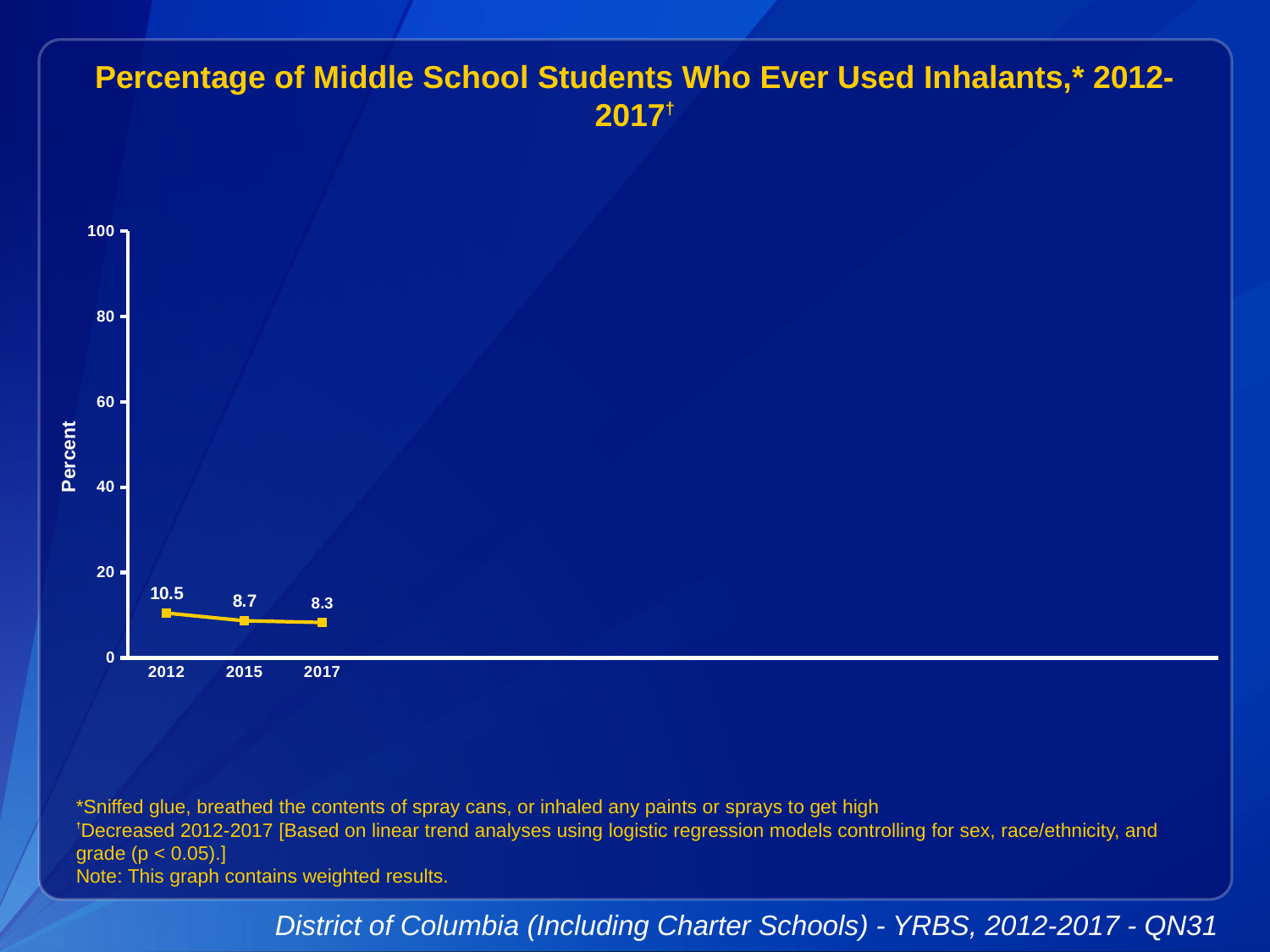
Which year has a larger value, 2012 or 2017? 2012 What is the difference between the 2012 and 2017 values? 2.2 Which year has the highest percentage of middle school students who ever used inhalants? 2012 How many years are plotted on the chart? 3 What kind of chart is shown on the slide? line chart Do the values rise or fall from 2012 to 2017? fall Is the value for 2012 greater or less than 20? less What percentage of middle school students had ever used inhalants in 2017? 8.3 What percentage of middle school students had ever used inhalants in 2015? 8.7 What is the difference between the 2012 and 2015 values? 1.8 Which year has the lowest percentage of middle school students who ever used inhalants? 2017 What percentage of middle school students had ever used inhalants in 2012? 10.5